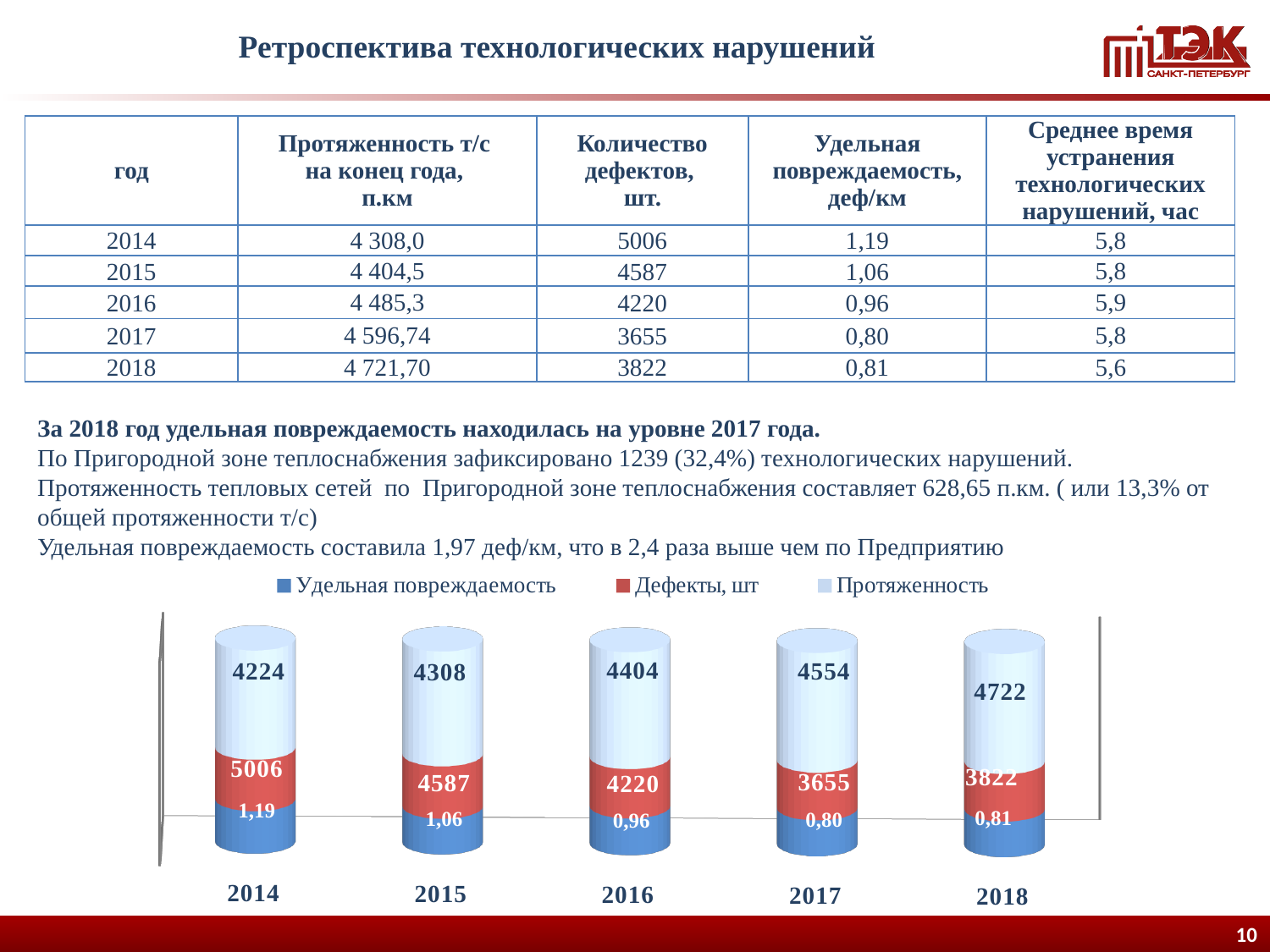
In the chart, what is the difference between the Дефекты, шт values for 2014 and 2015? 419 In the chart, which year has the lowest value of Протяженность? 2014 In the chart, do the Протяженность values rise or fall from 2014 to 2018? rise In the chart, what is the value of Дефекты, шт for 2014? 5006 In the chart, what is the value of Удельная повреждаемость for 2016? 0,96 In the chart, is the Дефекты, шт value larger for 2017 or for 2018? 2018 In the chart, what is the value of Протяженность for 2018? 4722 In the chart, which year has the highest value of Дефекты, шт? 2014 In the chart, which year has the lowest value of Дефекты, шт? 2017 How many series does the chart legend list? 3 How many years are shown along the x axis of the chart? 5 What kind of chart is shown at the bottom of the slide? stacked bar chart